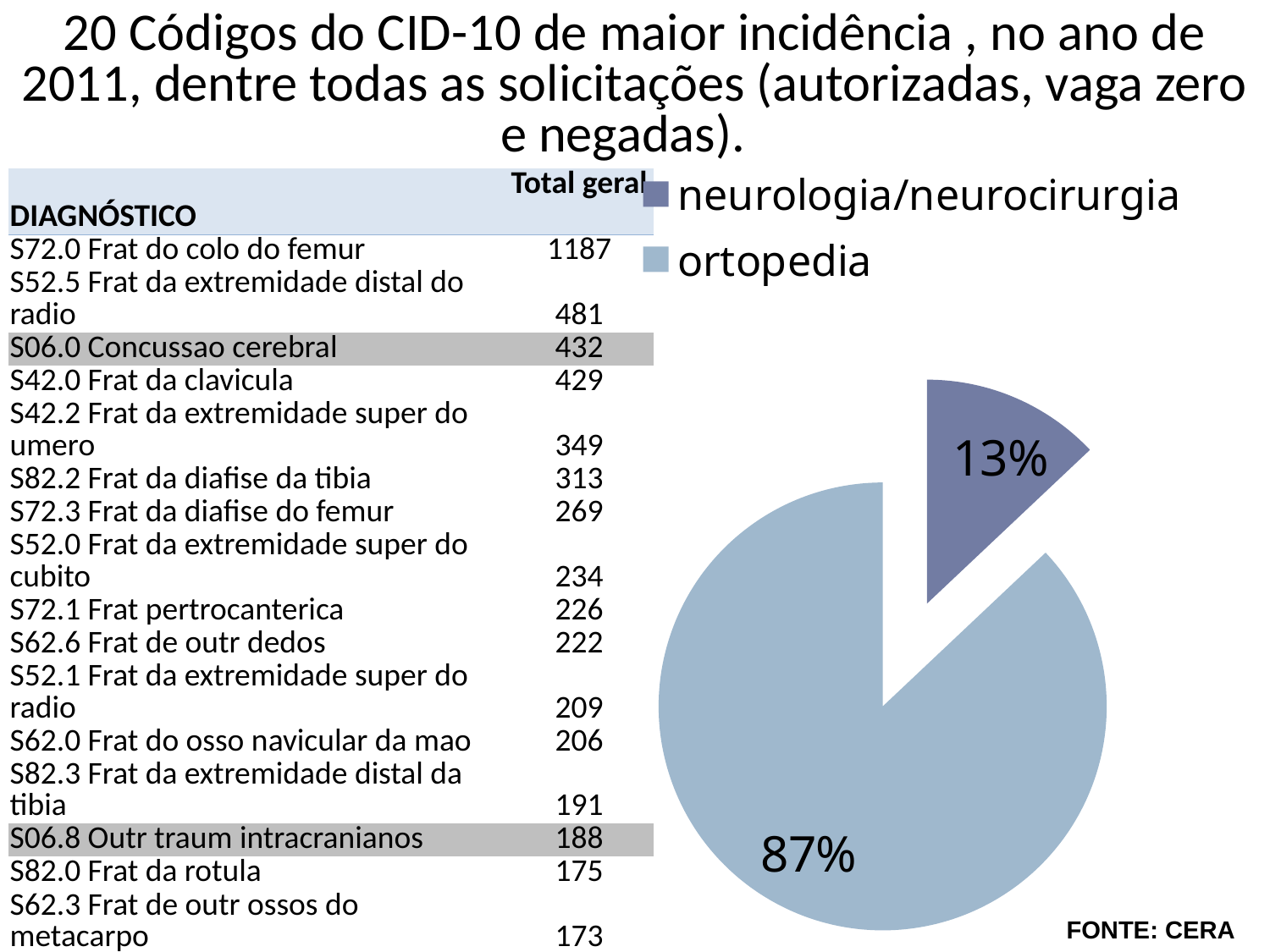
Which slice of the pie chart is the largest? ortopedia Which colour represents ortopedia in the pie chart? light blue Is the share for neurologia/neurocirurgia greater or less than 50%? less Which is larger in the pie chart, ortopedia or neurologia/neurocirurgia? ortopedia What kind of chart is shown on the slide? pie chart How many slices does the pie chart have? 2 Which slice of the pie chart is the smallest? neurologia/neurocirurgia What share of the pie chart does neurologia/neurocirurgia represent? 13% What share of the pie chart does ortopedia represent? 87% What is the difference in percentage points between the ortopedia slice and the neurologia/neurocirurgia slice? 74 How many entries does the pie chart legend list? 2 What source is cited below the pie chart? FONTE: CERA